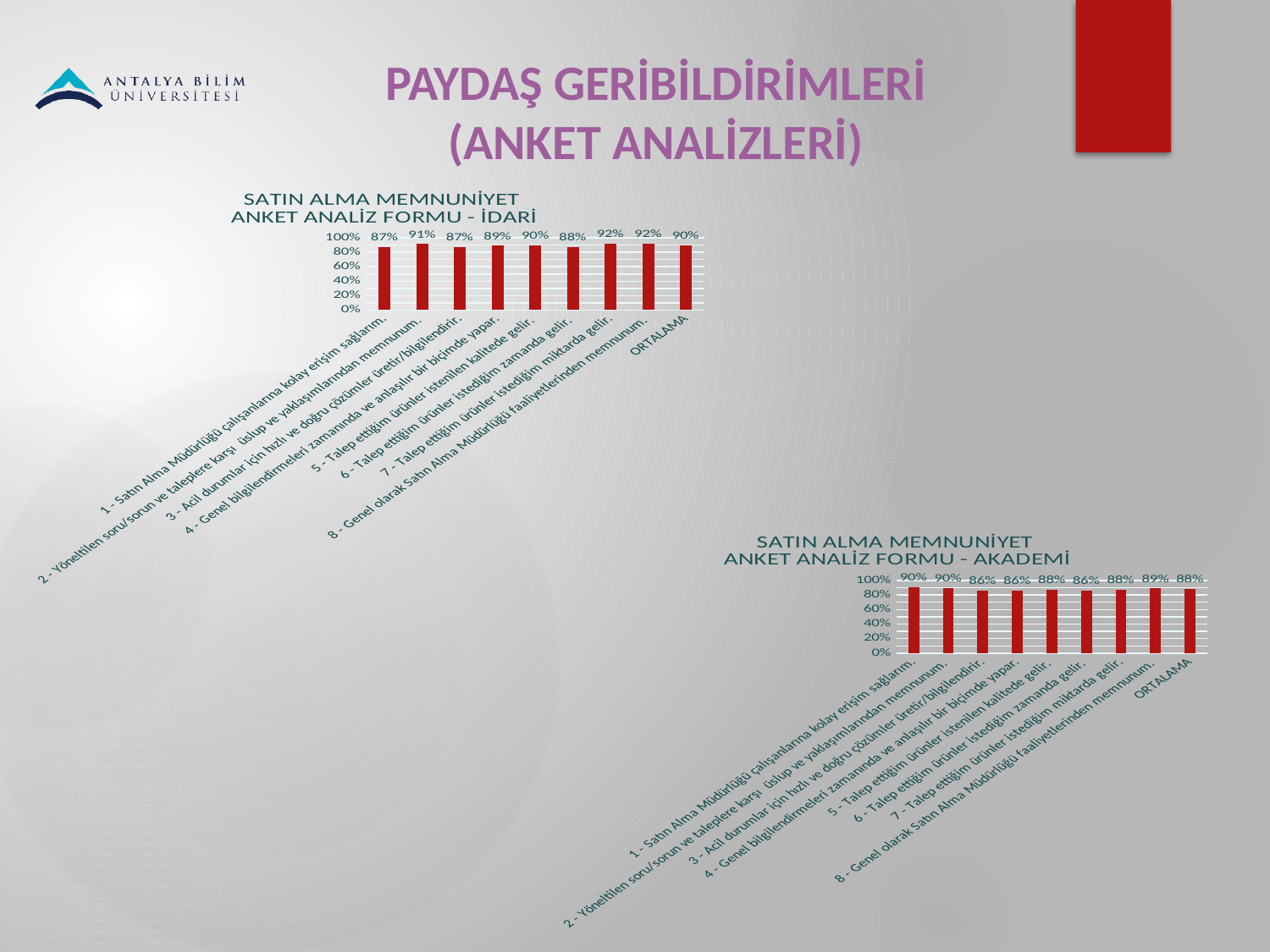
In the 'SATIN ALMA MEMNUNİYET ANKET ANALİZ FORMU - AKADEMİ' chart, what is the value for ORTALAMA? 88% In the İDARİ chart, what is the value for item 2 (Yöneltilen soru/sorun ve taleplere karşı üslup ve yaklaşımlarından memnunum)? 91% In the İDARİ chart, what is the lowest value shown among the data labels? 87% In the 'SATIN ALMA MEMNUNİYET ANKET ANALİZ FORMU - İDARİ' chart, what is the value for ORTALAMA? 90% Which chart has the higher ORTALAMA value, İDARİ or AKADEMİ? İDARİ In the İDARİ chart, what is the difference between the value for item 7 and the value for item 1? 5% What type of chart is the AKADEMİ chart? Bar chart In the AKADEMİ chart, what is the highest value shown among the data labels? 90% In the AKADEMİ chart, what is the value for item 8 (Genel olarak Satın Alma Müdürlüğü faaliyetlerinden memnunum)? 89% How many bars are plotted in the İDARİ chart? 9 What colour are the bars in both charts on the slide? Red In the AKADEMİ chart, is the value for item 3 greater or less than 80%? greater